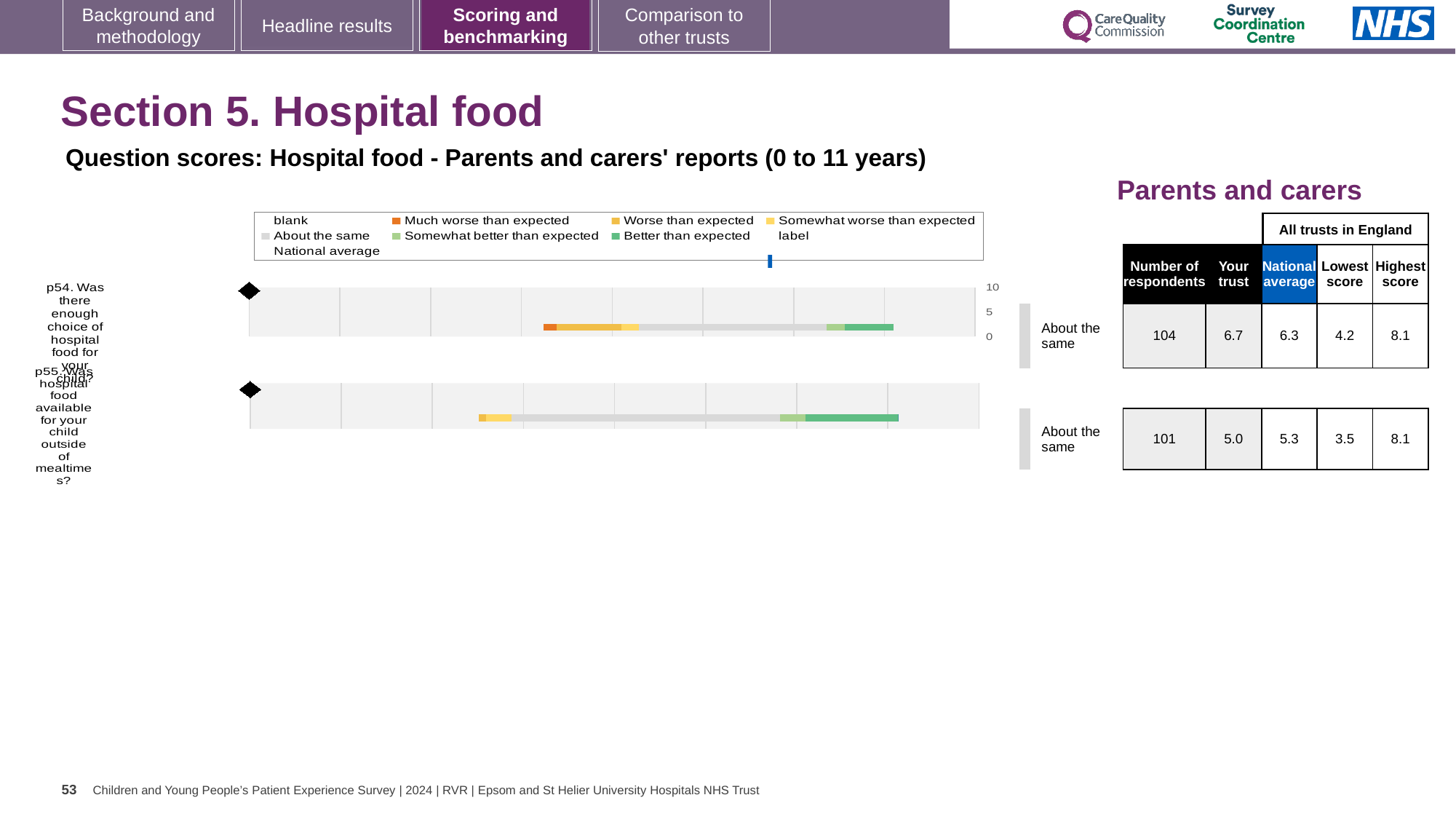
What kind of chart is used to show the question scores for p54 and p55? bar chart What is the 'Your trust' score for p54 (enough choice of hospital food)? 6.7 What is the highest tick value shown on the vertical axis of the p54 chart? 10 For p55, which is larger: the 'Your trust' score or the national average? National average For p54, which is larger: the 'Your trust' score or the national average? Your trust What is the national average score for p55 (hospital food available outside of mealtimes)? 5.3 How many respondents answered p55? 101 What benchmark category is shown for p54? About the same How many questions (p54 and p55) are plotted on the slide? 2 Which question has the higher 'Your trust' score, p54 or p55? p54 What is the highest score among all trusts in England for p55? 8.1 What is the difference between the highest score and the lowest score for p54? 3.9